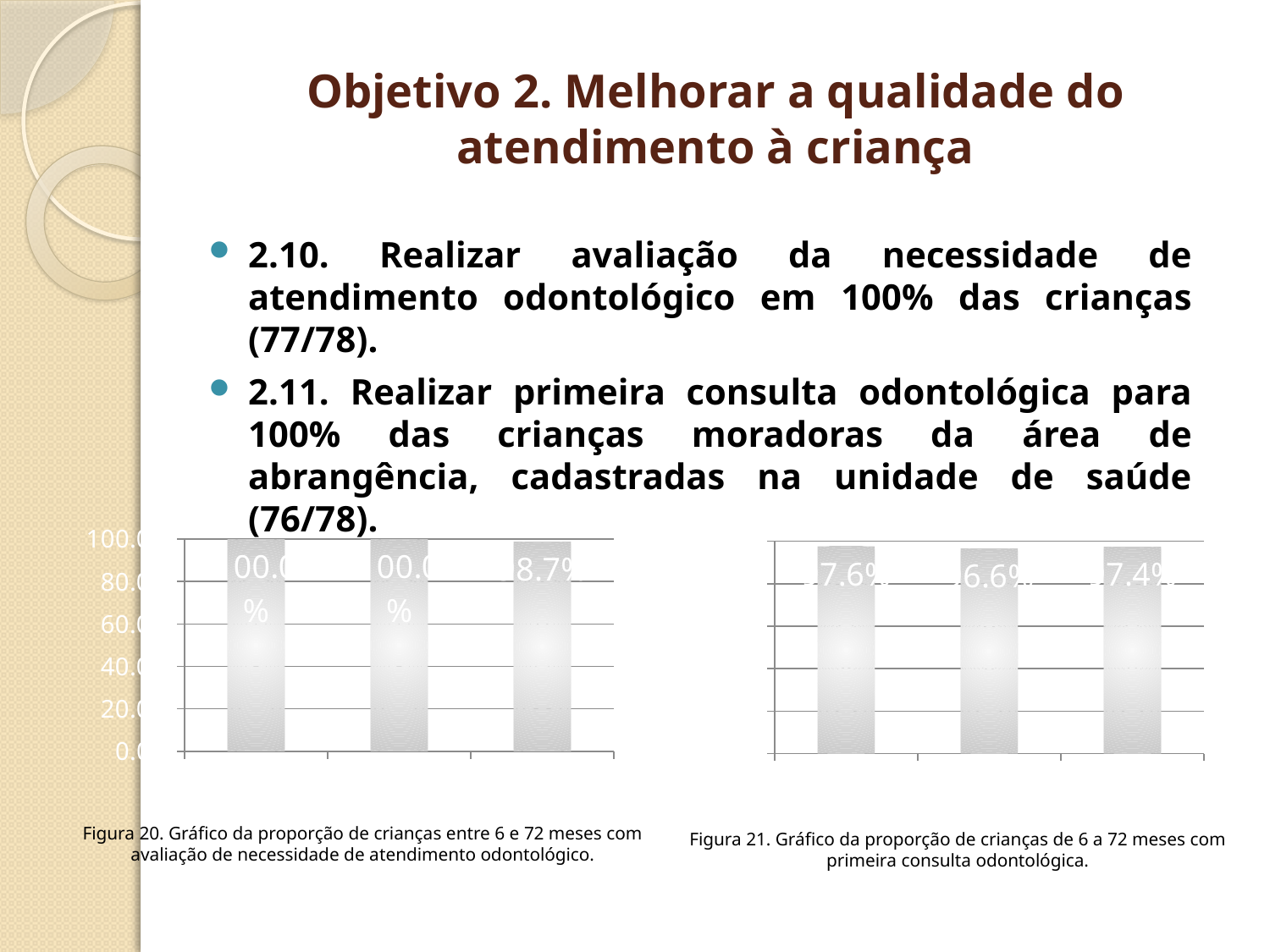
How many bars are plotted in Figura 21 (the right chart)? 3 What kind of chart is Figura 21 (the right chart)? bar chart In Figura 20 (the left chart), is the value of the second bar greater or less than 40.0? greater In Figura 20 (the left chart), is the value of the first bar greater or less than 80.0? greater What kind of chart is Figura 20 (the left chart)? bar chart In Figura 20 (the left chart), is the value of the third bar greater or less than 60.0? greater How many bars are plotted in Figura 20 (the left chart)? 3 What is the highest tick label shown on the y axis of Figura 20 (the left chart)? 100.0 What is the caption of the left chart on the slide? Figura 20. Gráfico da proporção de crianças entre 6 e 72 meses com avaliação de necessidade de atendimento odontológico.